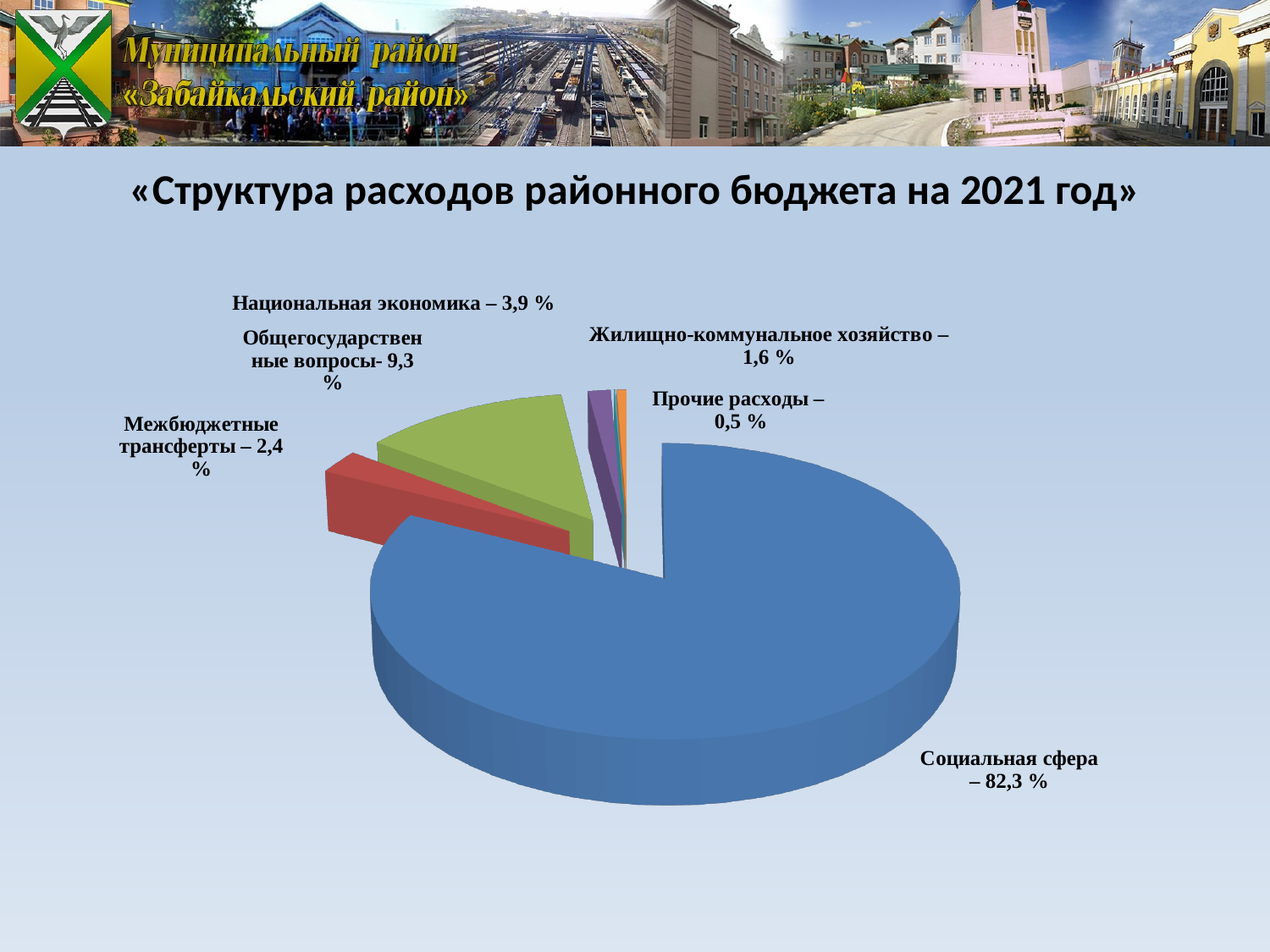
How many categories are shown in the pie chart? 6 Which category has the smallest share of the pie? Прочие расходы Which category has the largest share of the pie? Социальная сфера What share of the budget expenditures is Общегосударственные вопросы? 9,3 % What is the title of the chart on the slide? «Структура расходов районного бюджета на 2021 год» What share of the budget expenditures is Прочие расходы? 0,5 % What share of the budget expenditures is Межбюджетные трансферты? 2,4 % What share of the budget expenditures is Жилищно-коммунальное хозяйство? 1,6 % What kind of chart is shown on the slide? pie chart What share of the budget expenditures is Социальная сфера? 82,3 % What share of the budget expenditures is Национальная экономика? 3,9 % What is the difference between the shares of Общегосударственные вопросы and Национальная экономика? 5,4 %